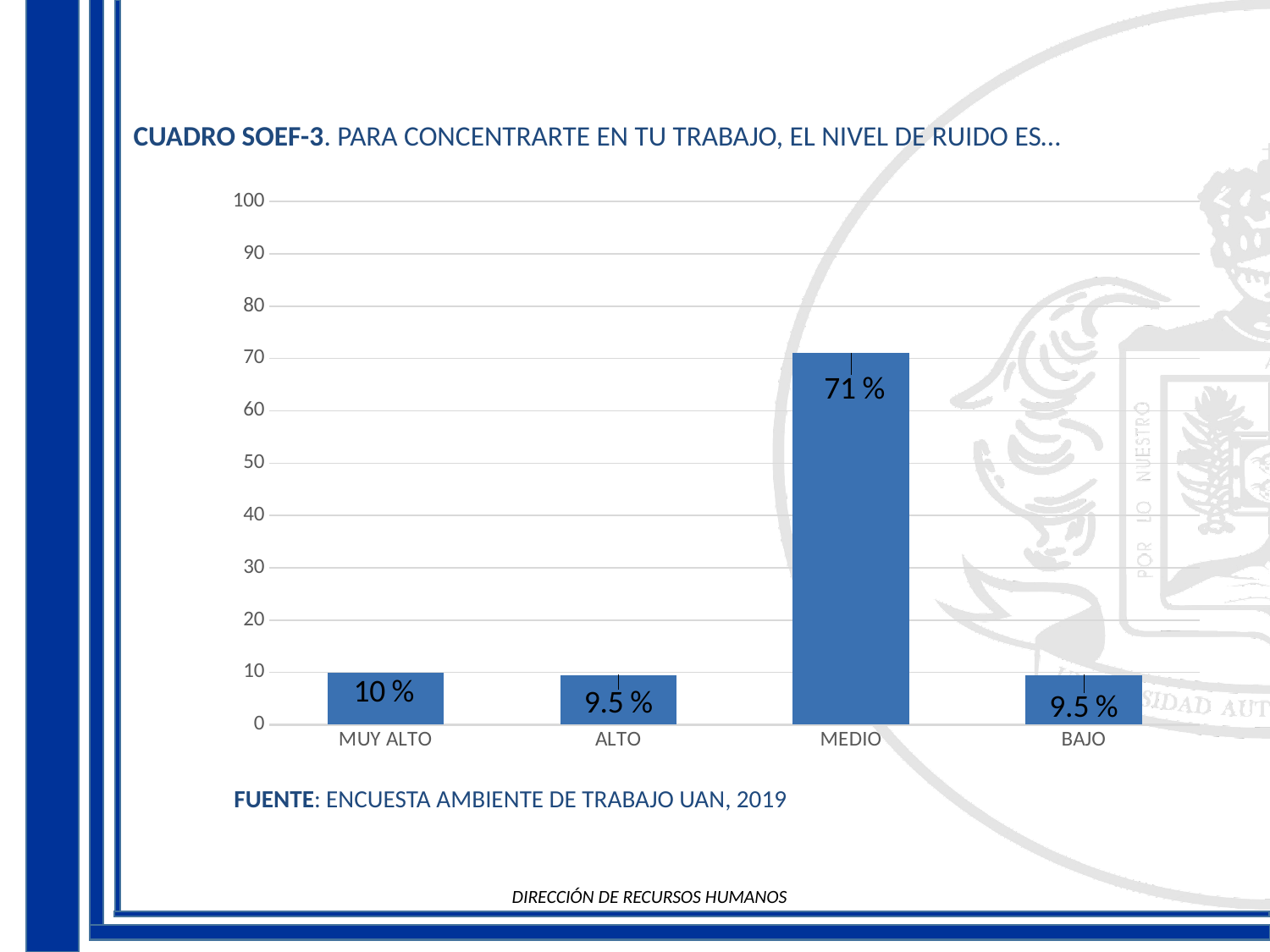
What is the value for BAJO? 9.5 % Is the value for MEDIO greater or less than 60? greater Which is larger, the value for MEDIO or the value for BAJO? MEDIO What is the value for MEDIO? 71 % What is the value for ALTO? 9.5 % Which category has the highest value? MEDIO How many categories are shown on the x axis? 4 What is the difference between the values for MEDIO and MUY ALTO? 61 % What source is cited below the chart? ENCUESTA AMBIENTE DE TRABAJO UAN, 2019 What kind of chart is shown on the slide? bar chart What is the difference between the values for MUY ALTO and ALTO? 0.5 % What is the value for MUY ALTO? 10 %